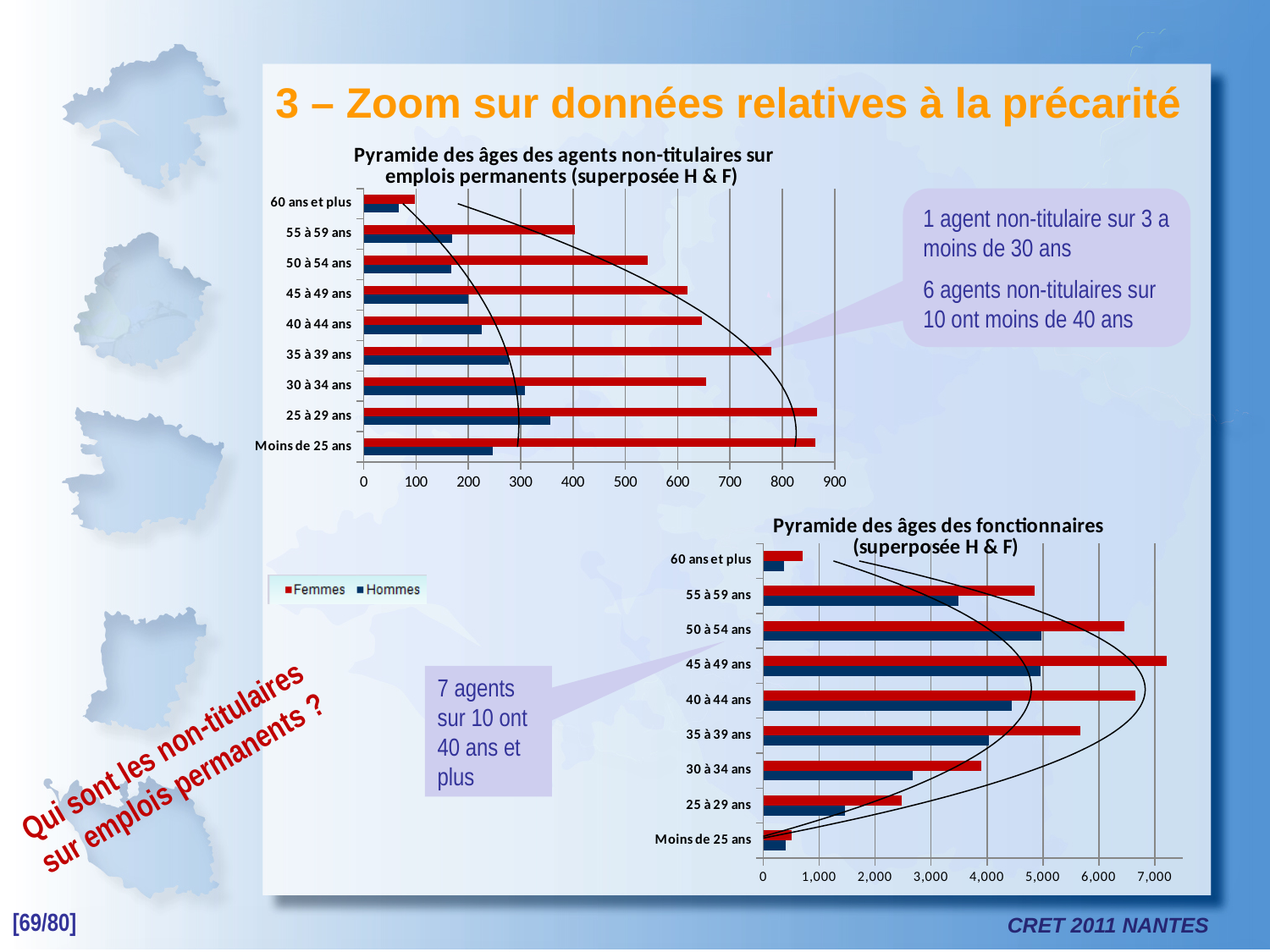
In the 'Pyramide des âges des agents non-titulaires' chart, is the Hommes value for 25 à 29 ans greater or less than 300? greater In the 'Pyramide des âges des agents non-titulaires' chart, which age category has the highest Hommes value? 25 à 29 ans In the 'Pyramide des âges des fonctionnaires' chart, for 25 à 29 ans, which is larger: the Femmes value or the Hommes value? Femmes Which two series are shown in the legend? Femmes and Hommes What kind of chart is the 'Pyramide des âges des agents non-titulaires sur emplois permanents' chart? Bar chart In the 'Pyramide des âges des fonctionnaires' chart, which age category has the highest Femmes value? 45 à 49 ans In the 'Pyramide des âges des agents non-titulaires' chart, which age category has the lowest Femmes value? 60 ans et plus How many age categories does the 'Pyramide des âges des fonctionnaires' chart show? 9 How many series does the legend list for the charts? 2 In the 'Pyramide des âges des agents non-titulaires' chart, is the Femmes value for 35 à 39 ans greater or less than 700? greater In the 'Pyramide des âges des fonctionnaires' chart, is the Hommes value for 55 à 59 ans greater or less than 3,000? greater In the 'Pyramide des âges des fonctionnaires' chart, which age category has the lowest Femmes value? Moins de 25 ans